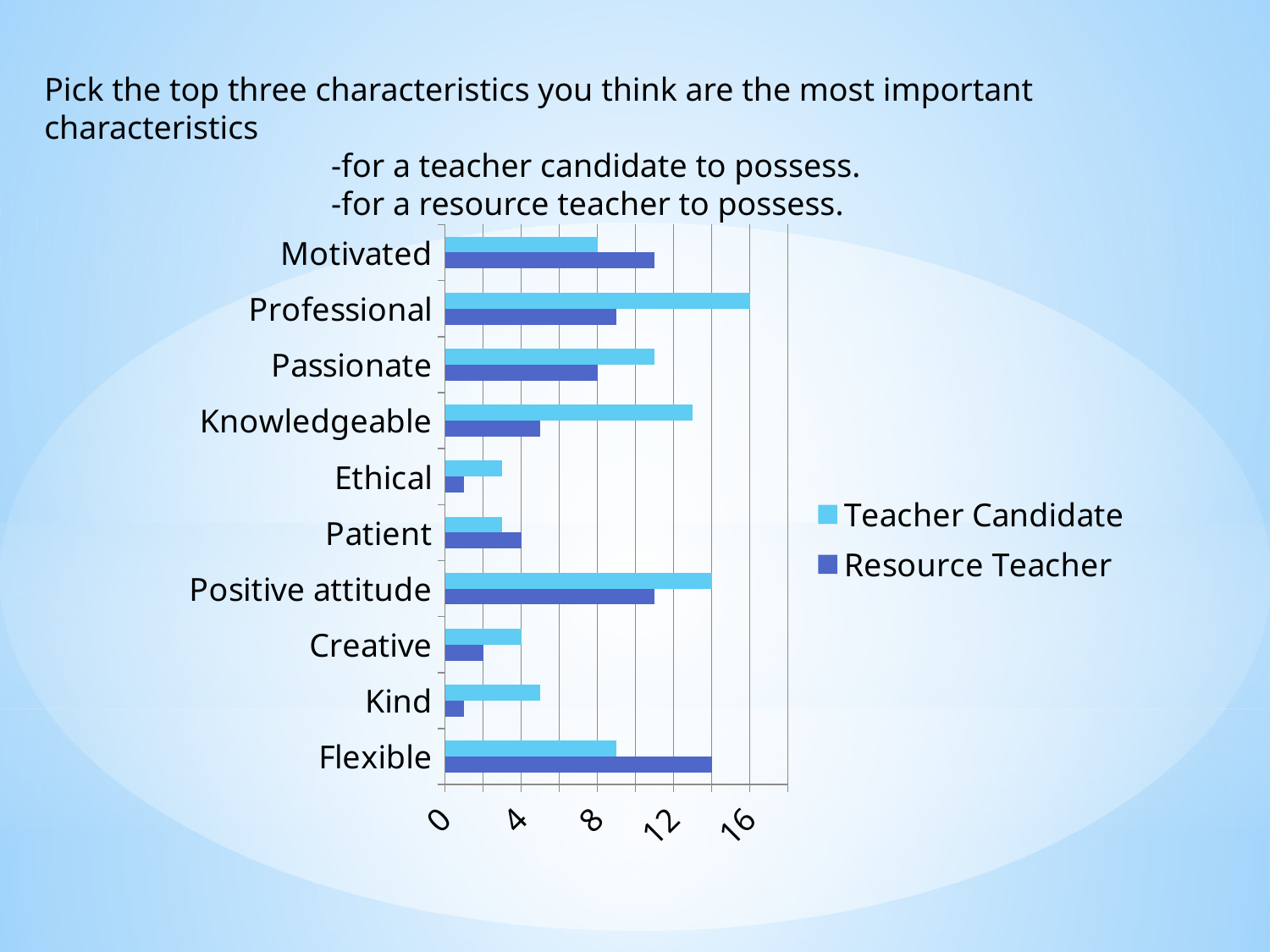
Which characteristic has the highest value for Teacher Candidate? Professional Which series is shown in the lighter blue colour in the legend? Teacher Candidate Is the Teacher Candidate value for Professional greater or less than 12? greater How many characteristics are listed on the vertical axis of the chart? 10 What kind of chart is shown on the slide? bar chart Is the Resource Teacher value for Knowledgeable greater or less than 8? less Is the Resource Teacher value for Flexible greater or less than 12? greater Which characteristic has the highest value for Resource Teacher? Flexible For Knowledgeable, which series has the larger value, Teacher Candidate or Resource Teacher? Teacher Candidate For Flexible, which series has the larger value, Teacher Candidate or Resource Teacher? Resource Teacher How many series does the chart legend list? 2